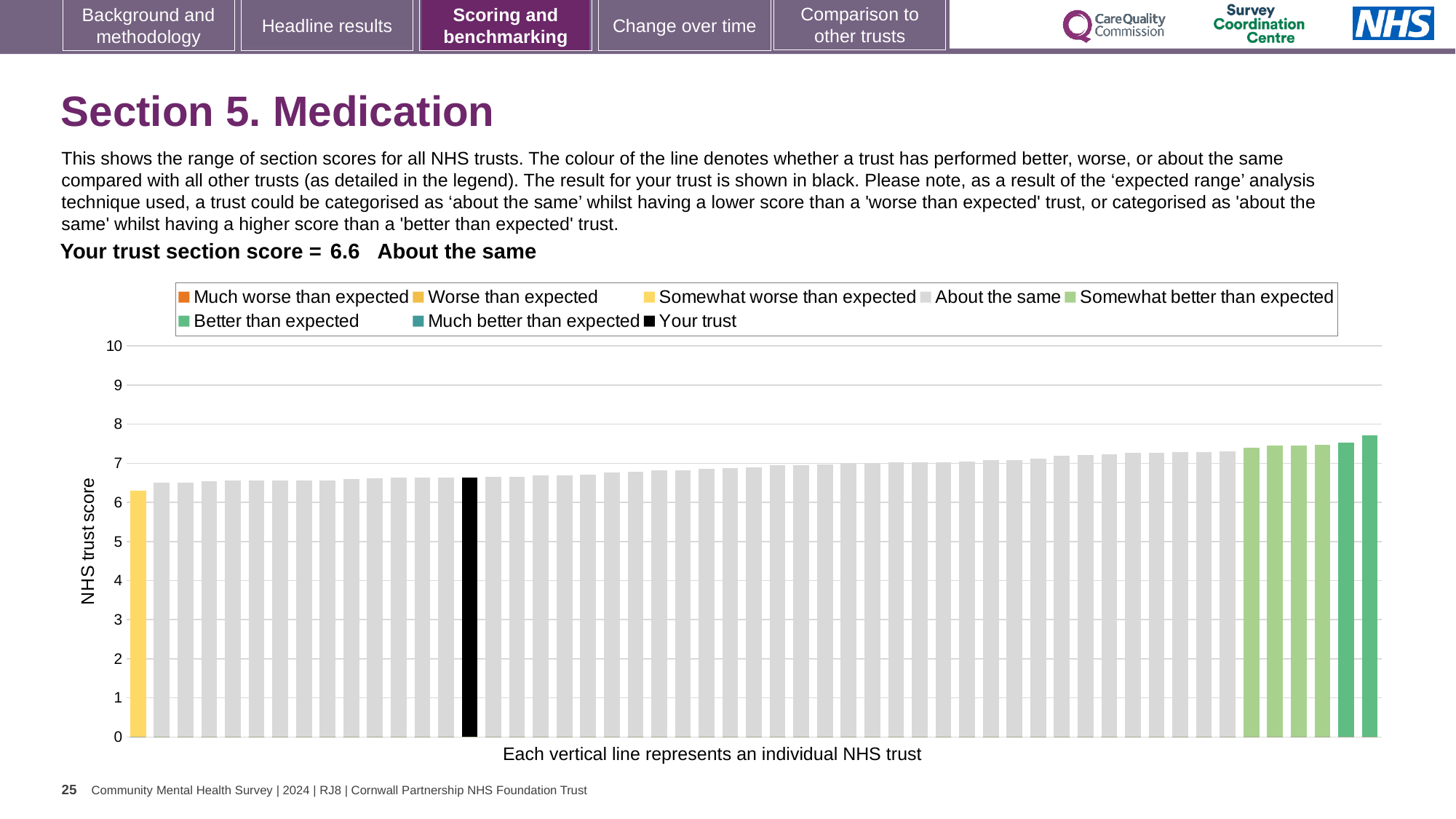
Which is larger: the rightmost bar or the black 'Your trust' bar? the rightmost bar What category does the black bar in the chart represent, according to the legend? Your trust Is the value of the rightmost bar greater or less than 7? greater How many entries does the chart legend list? 8 Is the value for your trust (the black bar) greater or less than 7? less Is the value for your trust (the black bar) greater or less than 6? greater What kind of chart is shown on the slide? bar chart What is the label on the y axis of the chart? NHS trust score What is the section score for your trust shown on the slide? 6.6 Do the bar values rise or fall from left to right along the x axis? rise